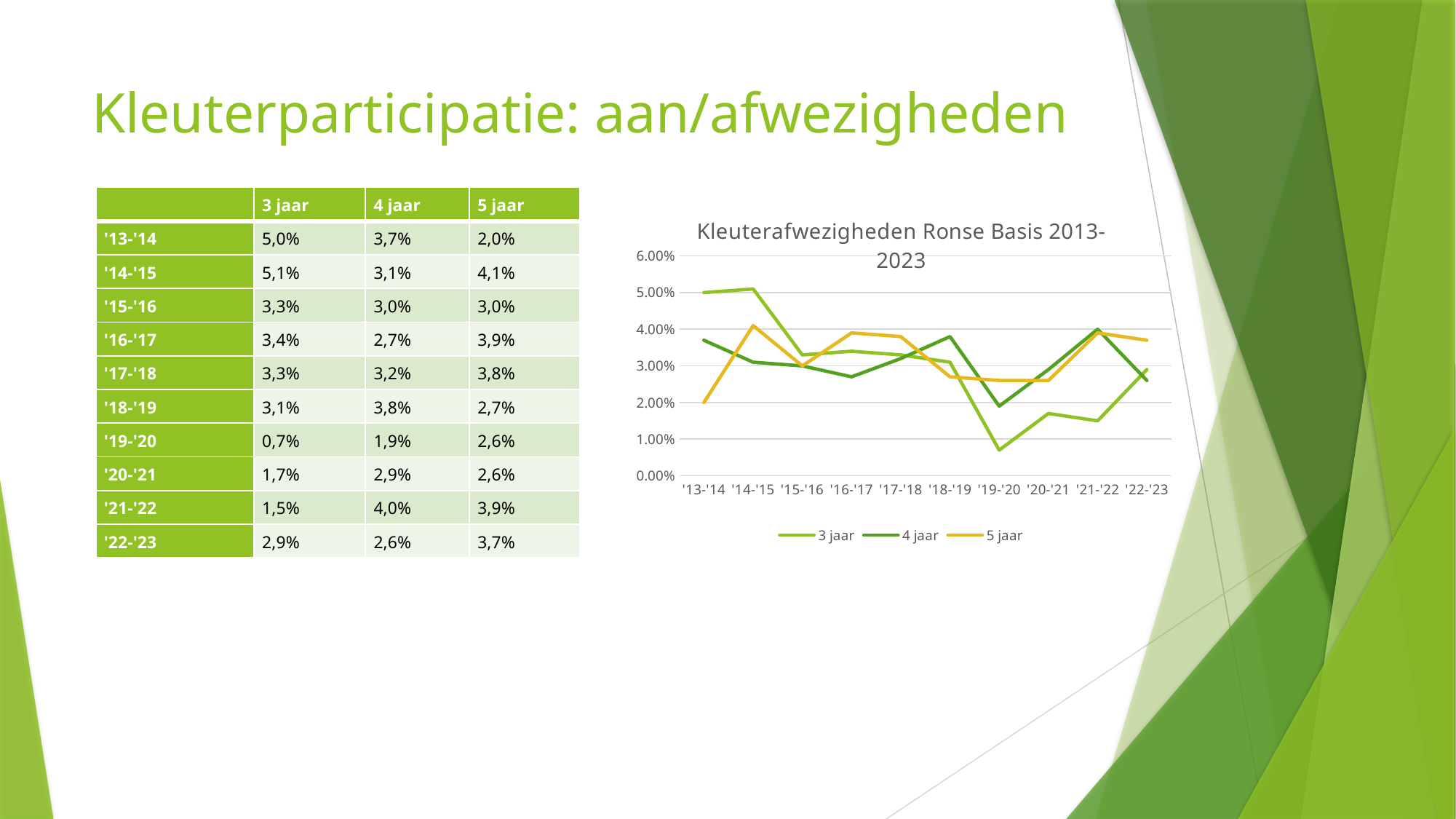
Does the 3 jaar series rise or fall from '13-'14 to '19-'20? fall How many series does the chart legend list? 3 What is the difference between the 3 jaar value in '13-'14 and the 3 jaar value in '22-'23? 2,1% What kind of chart is shown on the slide? line chart Is the value for 3 jaar in '13-'14 greater or less than 4.00%? greater In which school year is the 3 jaar series at its lowest? '19-'20 In '19-'20, which is larger: the value for 3 jaar or the value for 5 jaar? 5 jaar What is the value for 3 jaar in '19-'20? 0,7% In which school year is the 5 jaar series at its lowest? '13-'14 What is the title of the chart? Kleuterafwezigheden Ronse Basis 2013-2023 What is the value for 5 jaar in '13-'14? 2,0% How many school years are plotted along the x axis of the chart? 10